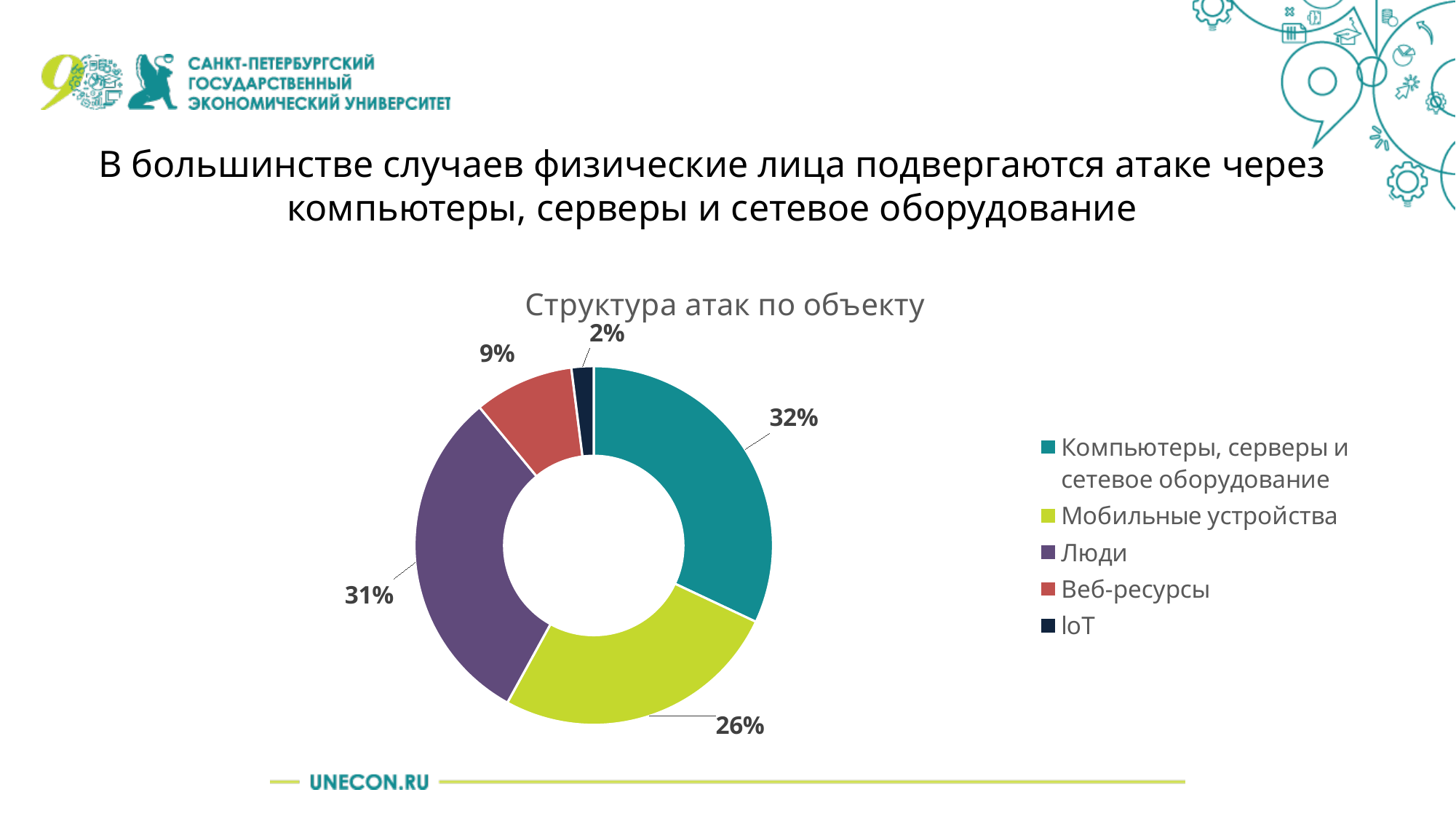
Which has a larger share: 'Веб-ресурсы' or 'IoT'? Веб-ресурсы How many categories are shown in the chart? 5 What share of attacks is attributed to 'IoT'? 2% What is the title of the chart? Структура атак по объекту What share of attacks is attributed to 'Люди'? 31% What share of attacks is attributed to 'Мобильные устройства'? 26% What type of chart is shown on the slide? Pie chart (doughnut) What is the difference in percentage points between 'Люди' and 'Мобильные устройства'? 5 What share of attacks is attributed to 'Компьютеры, серверы и сетевое оборудование'? 32% Which category has the largest share of attacks? Компьютеры, серверы и сетевое оборудование What share of attacks is attributed to 'Веб-ресурсы'? 9% Which category has the smallest share of attacks? IoT